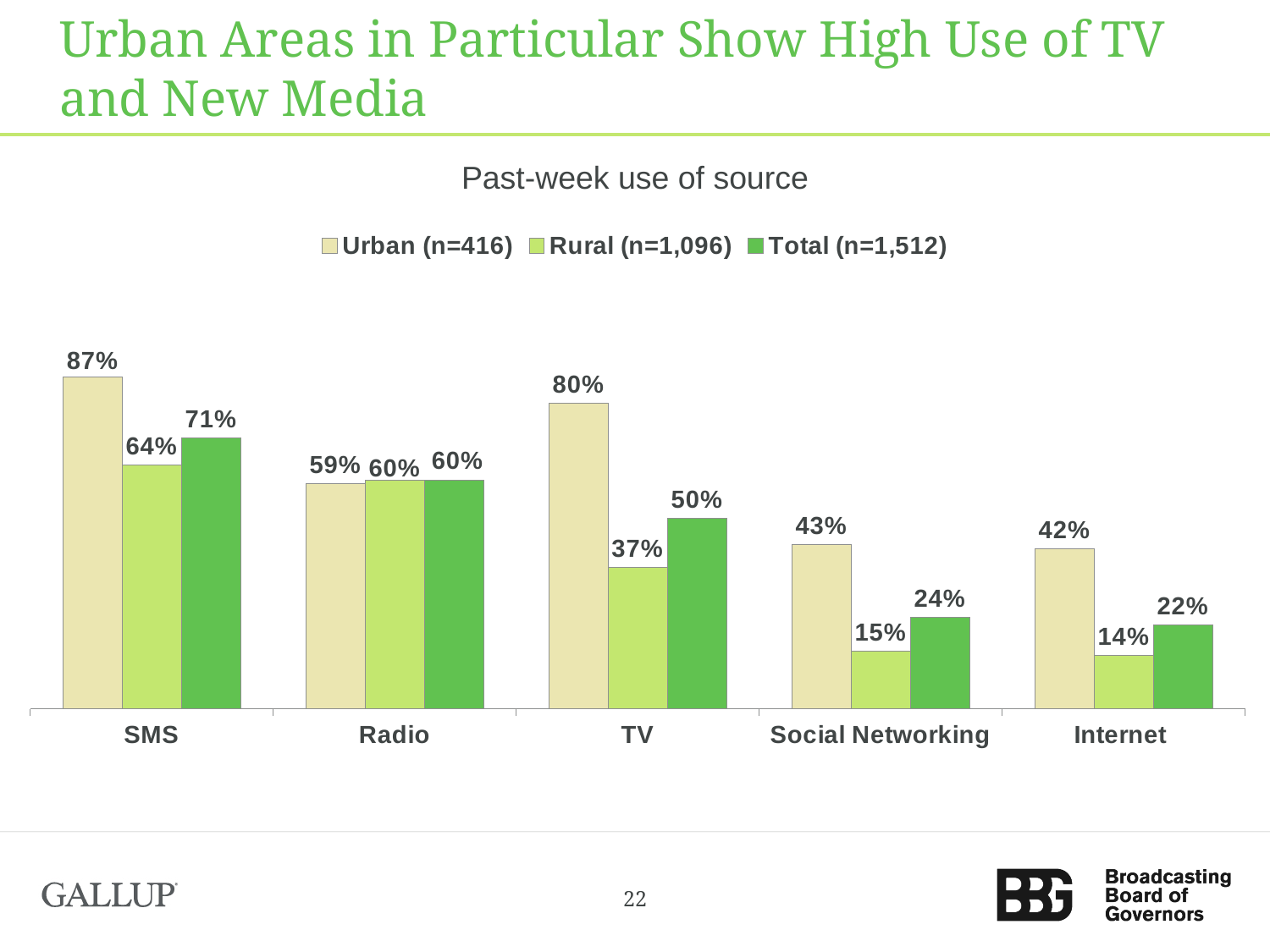
Which is larger, the Total (n=1,512) value for SMS or the Total (n=1,512) value for Radio? SMS Which category has the highest Urban (n=416) value? SMS What is the title of the chart? Past-week use of source What is the Urban (n=416) value for SMS? 87% How many categories are shown on the x axis? 5 What is the Total (n=1,512) value for Social Networking? 24% What is the difference between the Urban (n=416) and Rural (n=1,096) values for TV? 43% Which category has the lowest Rural (n=1,096) value? Internet How many series does the legend list? 3 What kind of chart is shown on the slide? Bar chart What is the Rural (n=1,096) value for TV? 37% What is the difference between the Urban (n=416) and Total (n=1,512) values for Internet? 20%